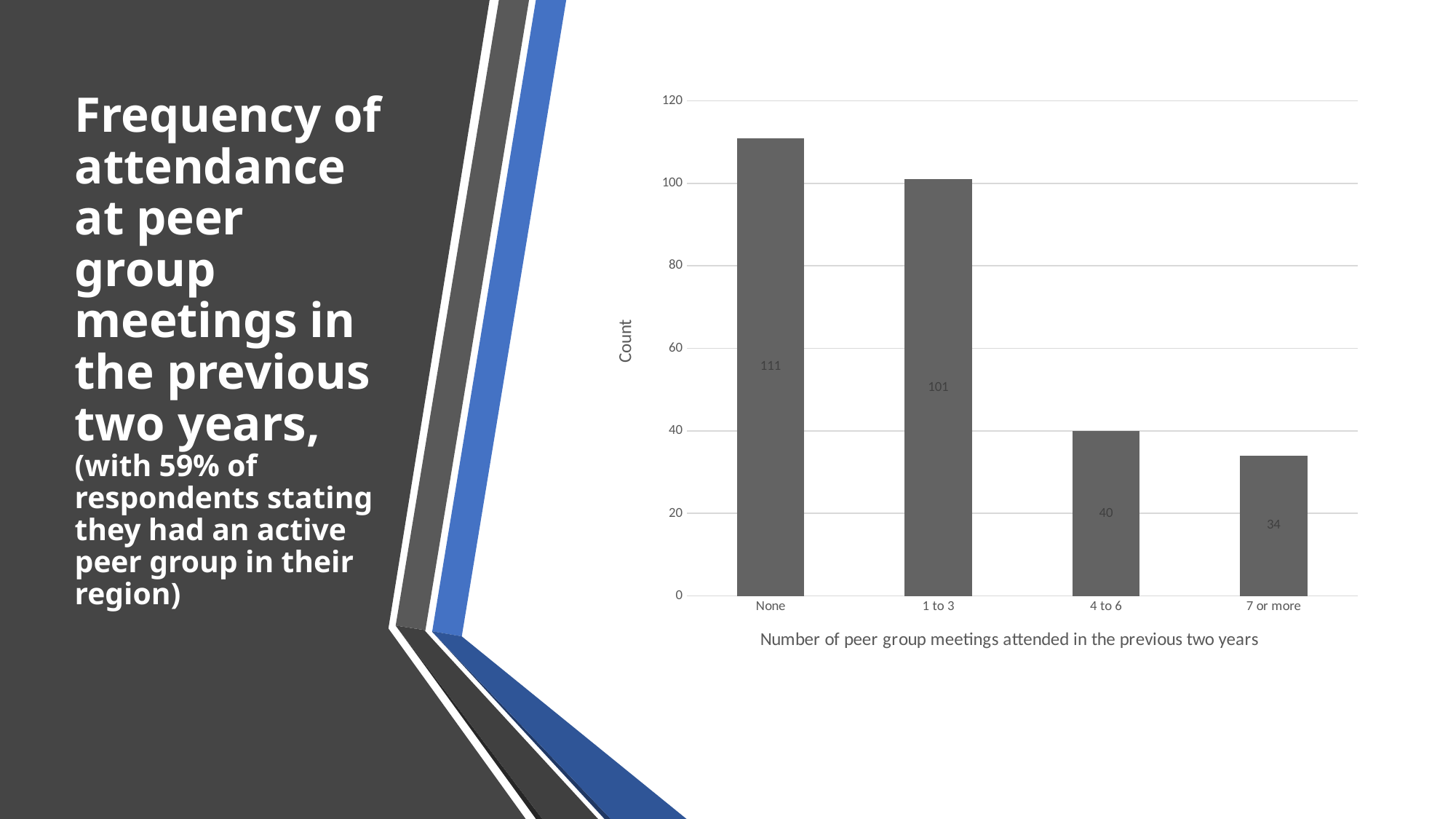
What is the difference between the counts for '4 to 6' and '7 or more'? 6 Which category has the highest count? None What is the difference between the counts for 'None' and '1 to 3'? 10 What is the count for the '7 or more' category? 34 What is the count for the '1 to 3' category? 101 What kind of chart is shown on the slide? Bar chart What is the count for the '4 to 6' category? 40 Which has a larger count, '1 to 3' or '4 to 6'? 1 to 3 How many categories are shown on the x axis? 4 What is the count for the 'None' category? 111 Which category has the lowest count? 7 or more What is the label of the x axis? Number of peer group meetings attended in the previous two years